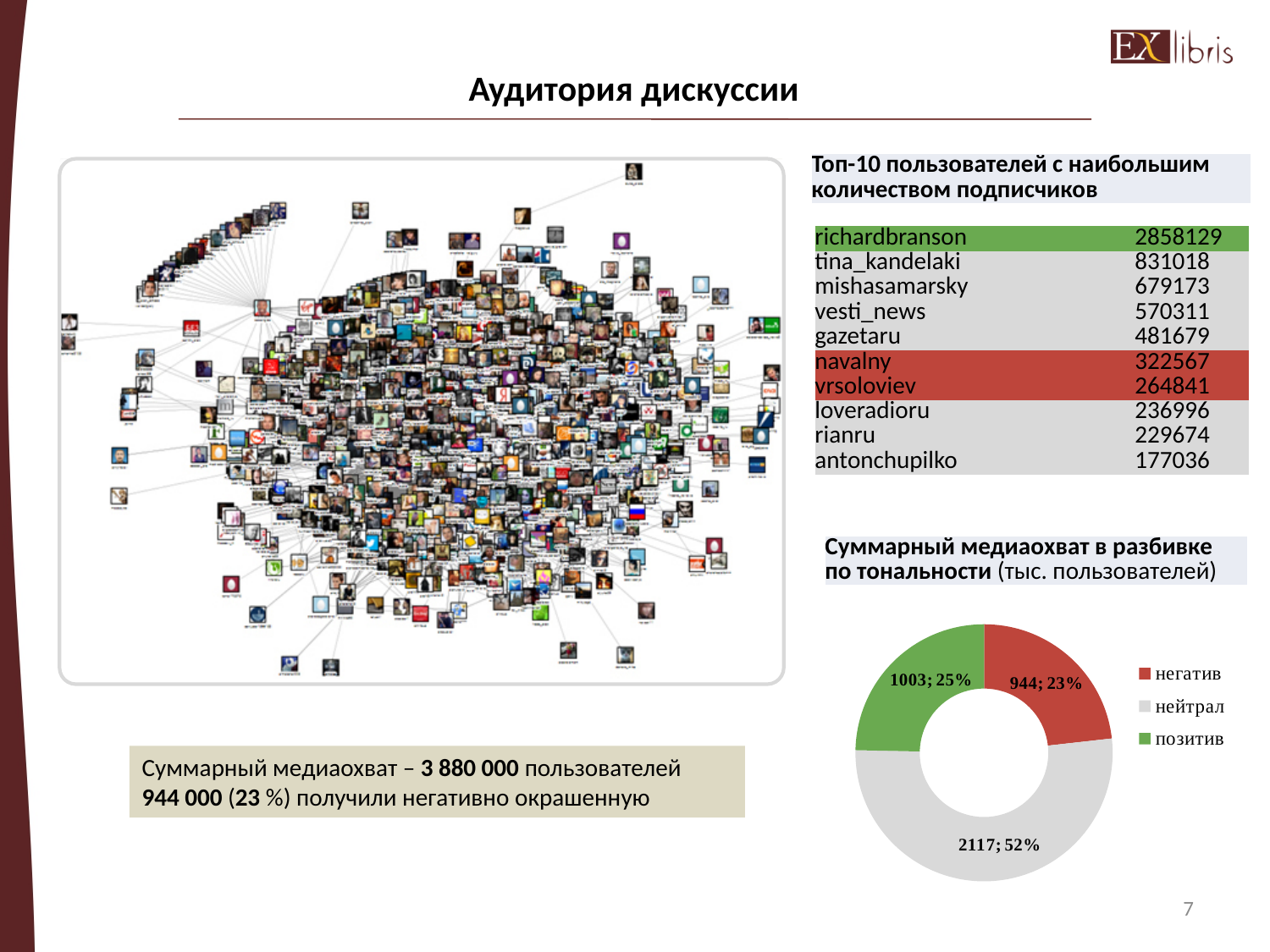
What value is shown for the негатив slice in the doughnut chart? 944 What value is shown for the позитив slice in the doughnut chart? 1003 What is the difference between the нейтрал and негатив values in the doughnut chart? 1173 What share of the doughnut chart does the позитив slice represent? 25% How many categories does the legend of the doughnut chart list? 3 Which is larger in the doughnut chart, позитив or негатив? позитив Which category has the largest slice in the doughnut chart? нейтрал What colour is the негатив slice in the doughnut chart? Red What share of the doughnut chart does the нейтрал slice represent? 52% What type of chart is used to show the media reach by tonality? Doughnut (pie) chart Which category has the smallest slice in the doughnut chart? негатив What value is shown for the нейтрал slice in the doughnut chart? 2117